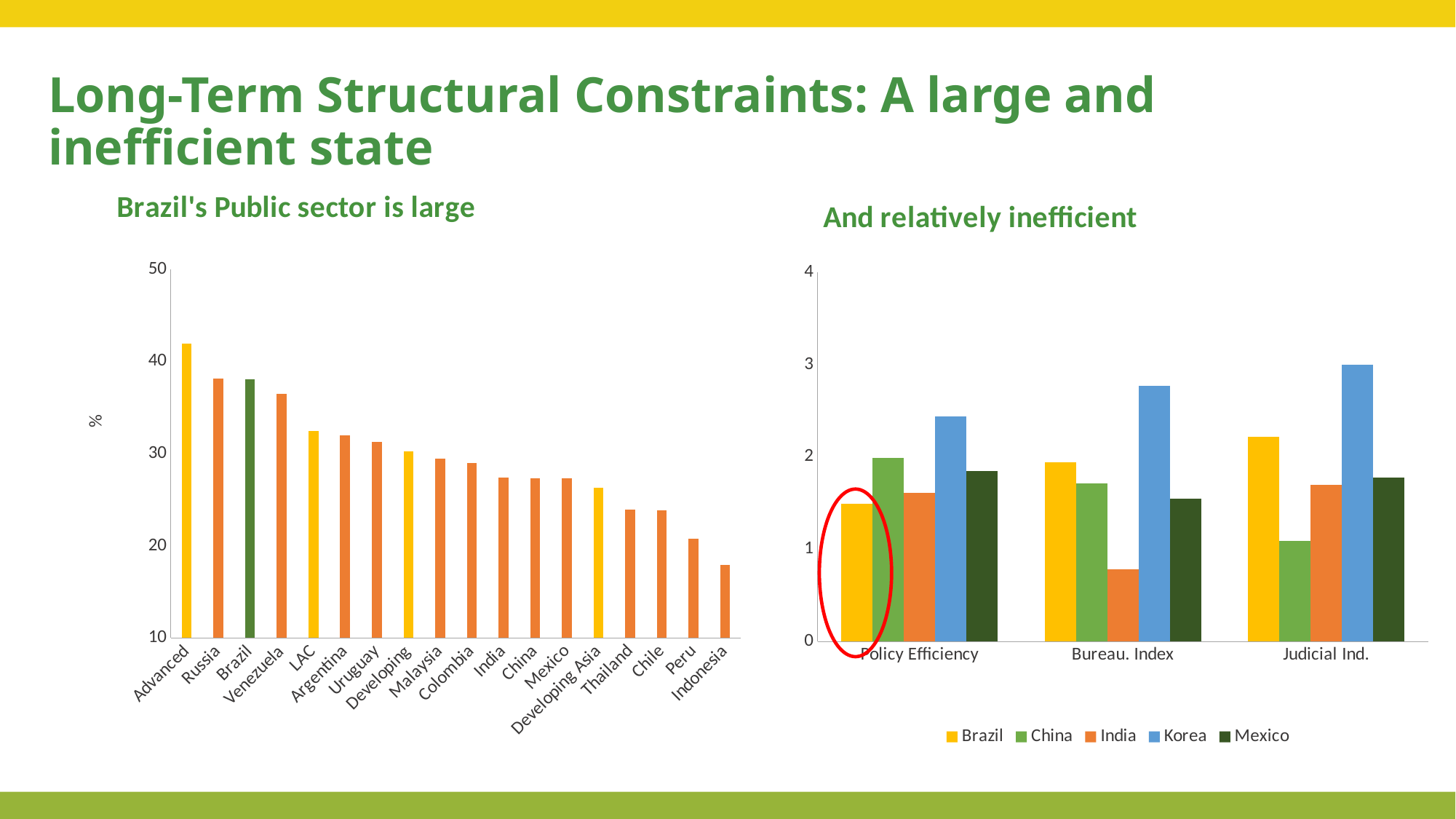
In the 'And relatively inefficient' chart, is the value for India in Bureau. Index greater or less than 1? less In the 'Brazil's Public sector is large' chart, which category has the lowest value? Indonesia In the 'And relatively inefficient' chart on the right, how many series does the legend list? 5 In the 'And relatively inefficient' chart, which bar is circled in red? Brazil in Policy Efficiency In the 'Brazil's Public sector is large' chart, which category has the highest value? Advanced What kind of chart is the 'Brazil's Public sector is large' chart on the left? Bar chart In the 'Brazil's Public sector is large' chart, which is larger, the value for Venezuela or the value for LAC? Venezuela In the 'Brazil's Public sector is large' chart, do the values rise or fall from left to right along the x axis? Fall In the 'And relatively inefficient' chart, which series has the highest value for Judicial Ind.? Korea In the 'Brazil's Public sector is large' chart, is the value for Indonesia greater or less than 20? less In the 'Brazil's Public sector is large' chart, is the value for Advanced greater or less than 40? greater In the 'Brazil's Public sector is large' chart, how many categories are shown on the x axis? 18